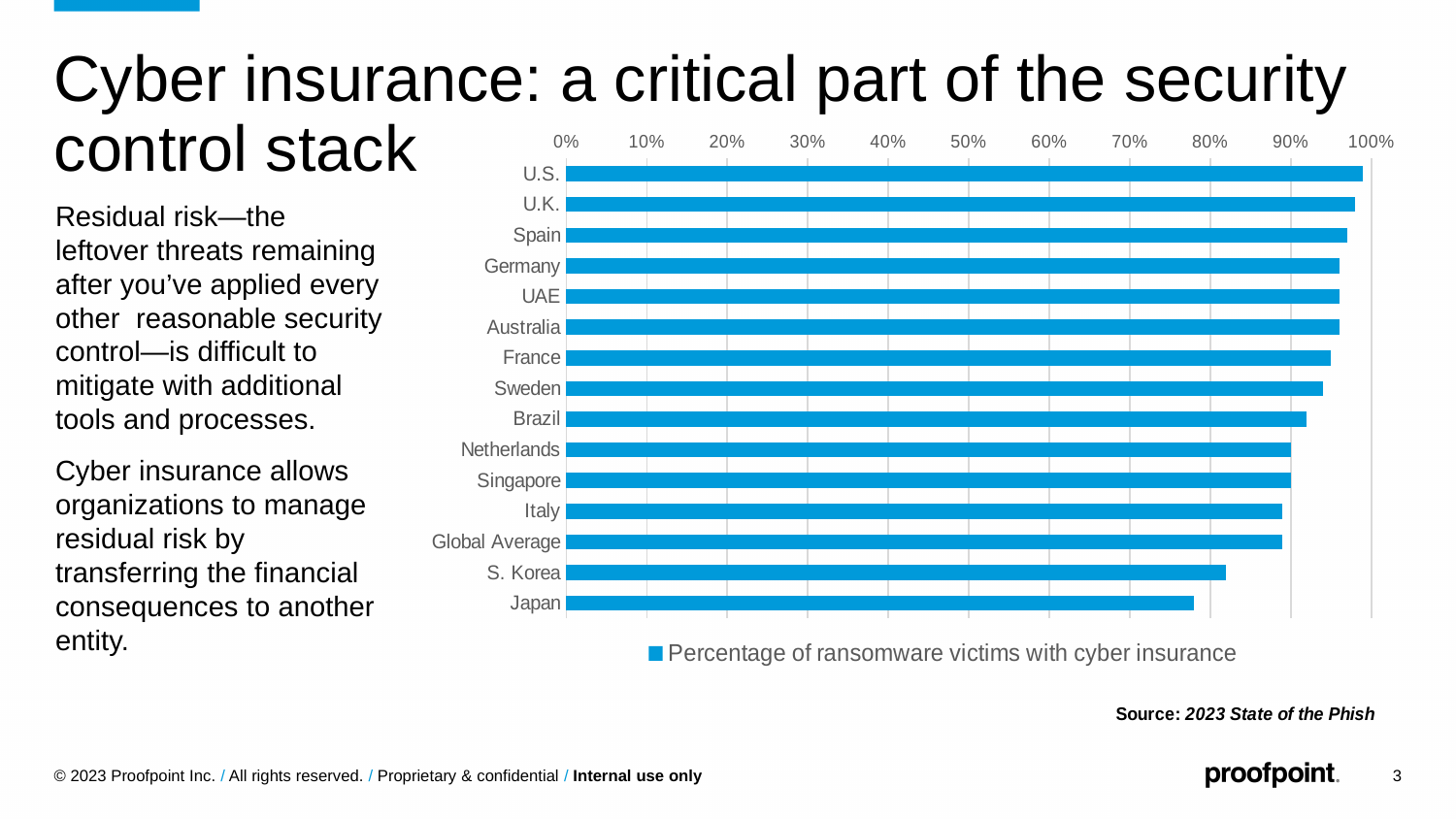
How many countries/categories are plotted in the chart? 15 What kind of chart is shown on the slide? bar chart How many series does the chart legend list? 1 Which has a higher percentage of ransomware victims with cyber insurance, Japan or Germany? Germany Which has a higher percentage of ransomware victims with cyber insurance, Spain or S. Korea? Spain Which category has the lowest percentage of ransomware victims with cyber insurance? Japan What series name does the chart legend show? Percentage of ransomware victims with cyber insurance Is the value for S. Korea greater or less than 90%? less Is the value for Netherlands greater or less than 80%? greater Is the value for U.S. greater or less than 90%? greater Which category has the highest percentage of ransomware victims with cyber insurance? U.S.